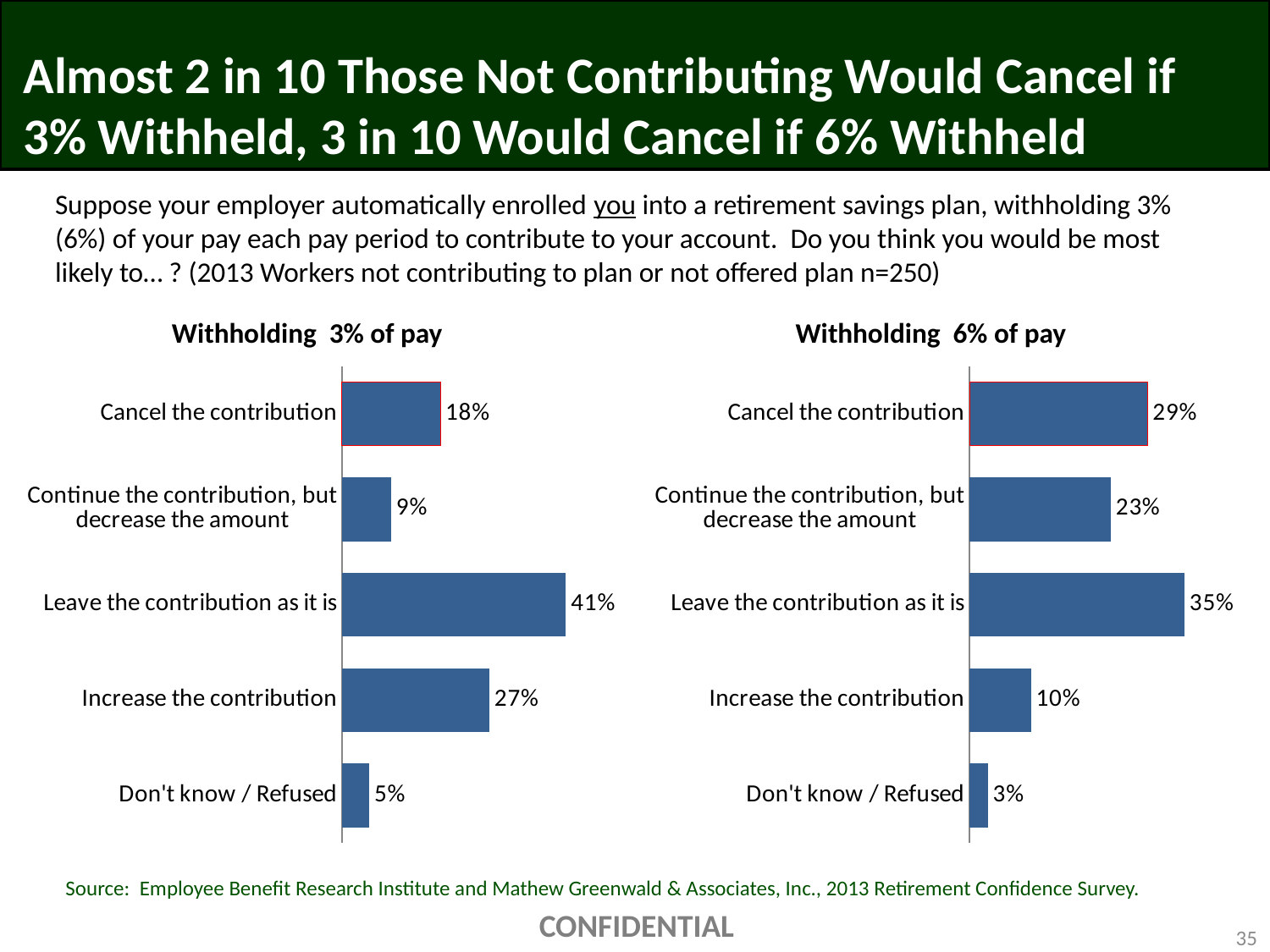
What kind of chart is the 'Withholding 6% of pay' chart? Bar chart What is the difference between the 'Cancel the contribution' values in the 'Withholding 6% of pay' chart and the 'Withholding 3% of pay' chart? 11 percentage points In the 'Withholding 3% of pay' chart, what is the difference between 'Leave the contribution as it is' and 'Increase the contribution'? 14 percentage points In the 'Withholding 3% of pay' chart, which category has the highest value? Leave the contribution as it is How many charts are shown on the slide? 2 In the 'Withholding 6% of pay' chart, what is the value for 'Continue the contribution, but decrease the amount'? 23% In the 'Withholding 3% of pay' chart, what is the value for 'Cancel the contribution'? 18% In the 'Withholding 6% of pay' chart, which category has the lowest value? Don't know / Refused How many categories are shown in the 'Withholding 3% of pay' chart? 5 In the 'Withholding 6% of pay' chart, what is the value for 'Don't know / Refused'? 3% In the 'Withholding 6% of pay' chart, which is larger: 'Cancel the contribution' or 'Leave the contribution as it is'? Leave the contribution as it is Which is larger: 'Increase the contribution' in the 'Withholding 3% of pay' chart or 'Increase the contribution' in the 'Withholding 6% of pay' chart? Withholding 3% of pay